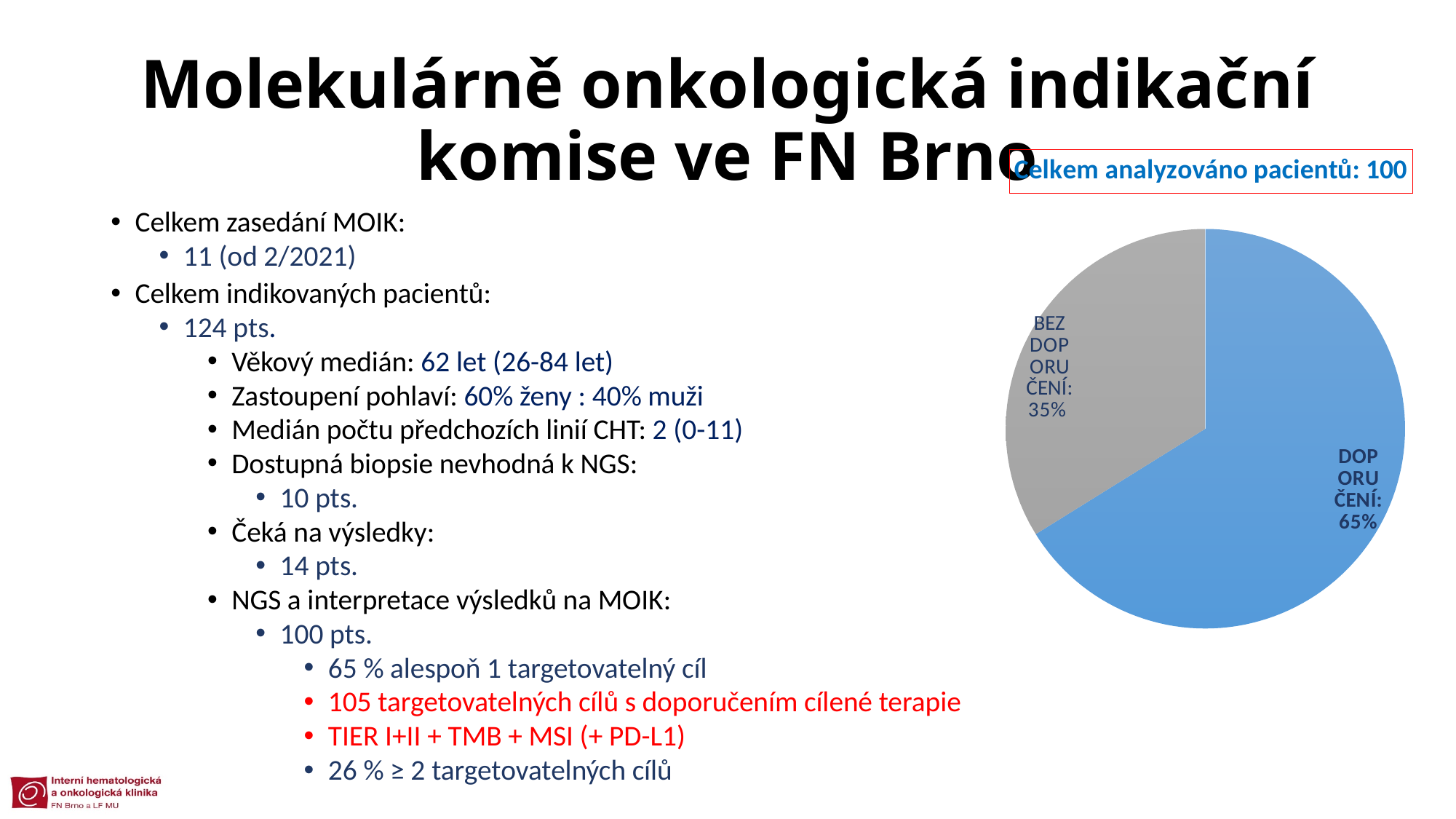
What share of the pie does the DOPORUČENÍ slice represent? 65% Which is larger in the pie chart, DOPORUČENÍ or BEZ DOPORUČENÍ? DOPORUČENÍ What is the total number of analysed patients stated above the pie chart? 100 What colour is the DOPORUČENÍ slice of the pie chart? blue How many slices does the pie chart have? 2 What kind of chart is shown on the slide? pie chart Which slice of the pie chart is the smallest? BEZ DOPORUČENÍ Which slice of the pie chart is the largest? DOPORUČENÍ What share of the pie does the BEZ DOPORUČENÍ slice represent? 35% What is the difference in percentage points between the DOPORUČENÍ and BEZ DOPORUČENÍ slices? 30